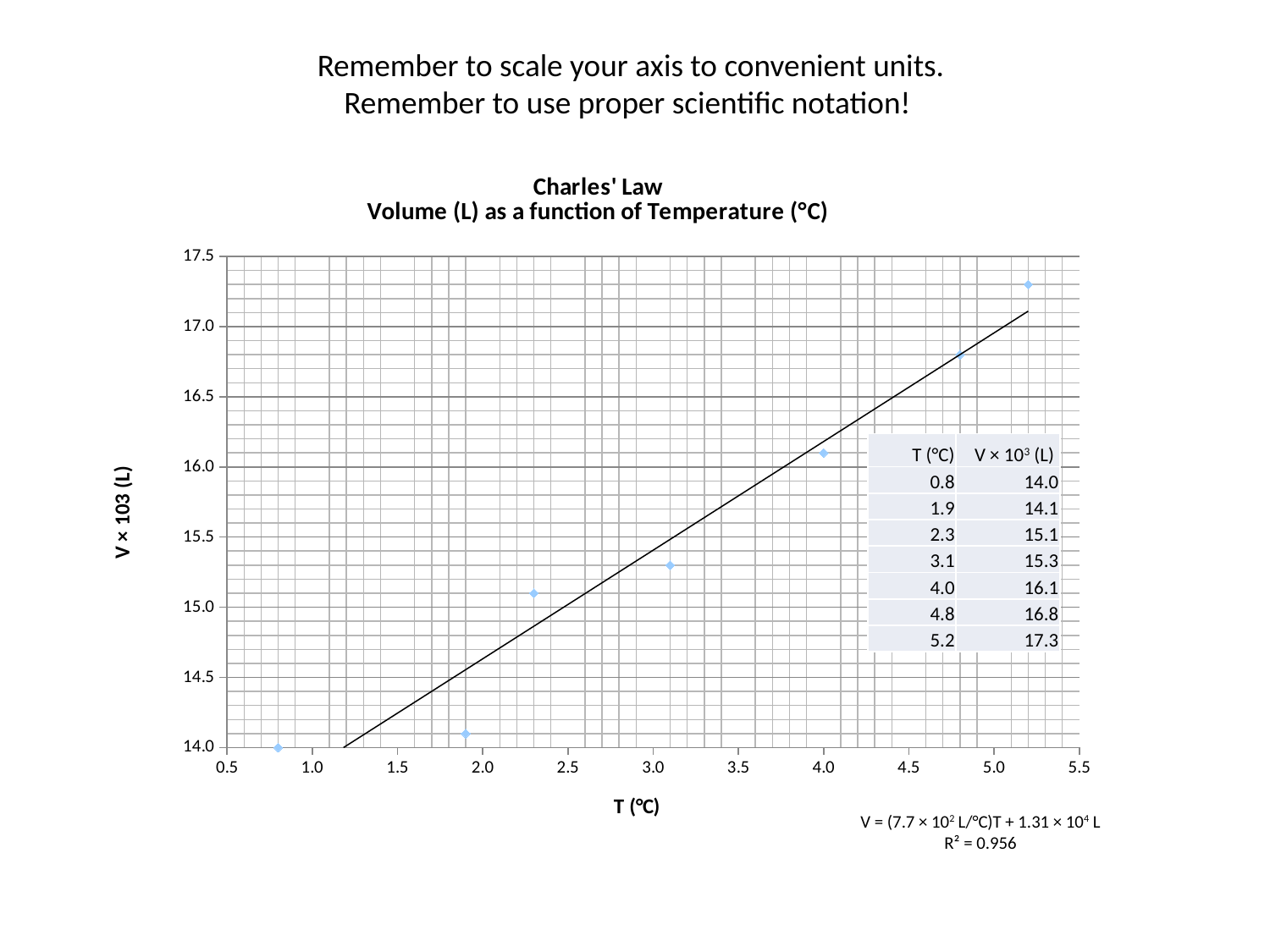
How many data points are plotted on the chart? 7 Which has the larger volume value, T = 3.1 or T = 4.0? 4.0 According to the data table, what is the value of V × 10³ (L) at T = 4.8 °C? 16.8 According to the data table, what is the value of V × 10³ (L) at T = 2.3 °C? 15.1 What is the difference between the V × 10³ values at T = 5.2 and T = 0.8? 3.3 What is the label of the x axis? T (°C) At which temperature is the volume value highest? 5.2 Is the volume value at T = 4.0 greater or less than 16.0? greater At which temperature is the volume value lowest? 0.8 What is the R² value shown for the trendline? 0.956 What type of chart is shown on the slide? scatter chart Do the volume values rise or fall as temperature increases along the x axis? rise